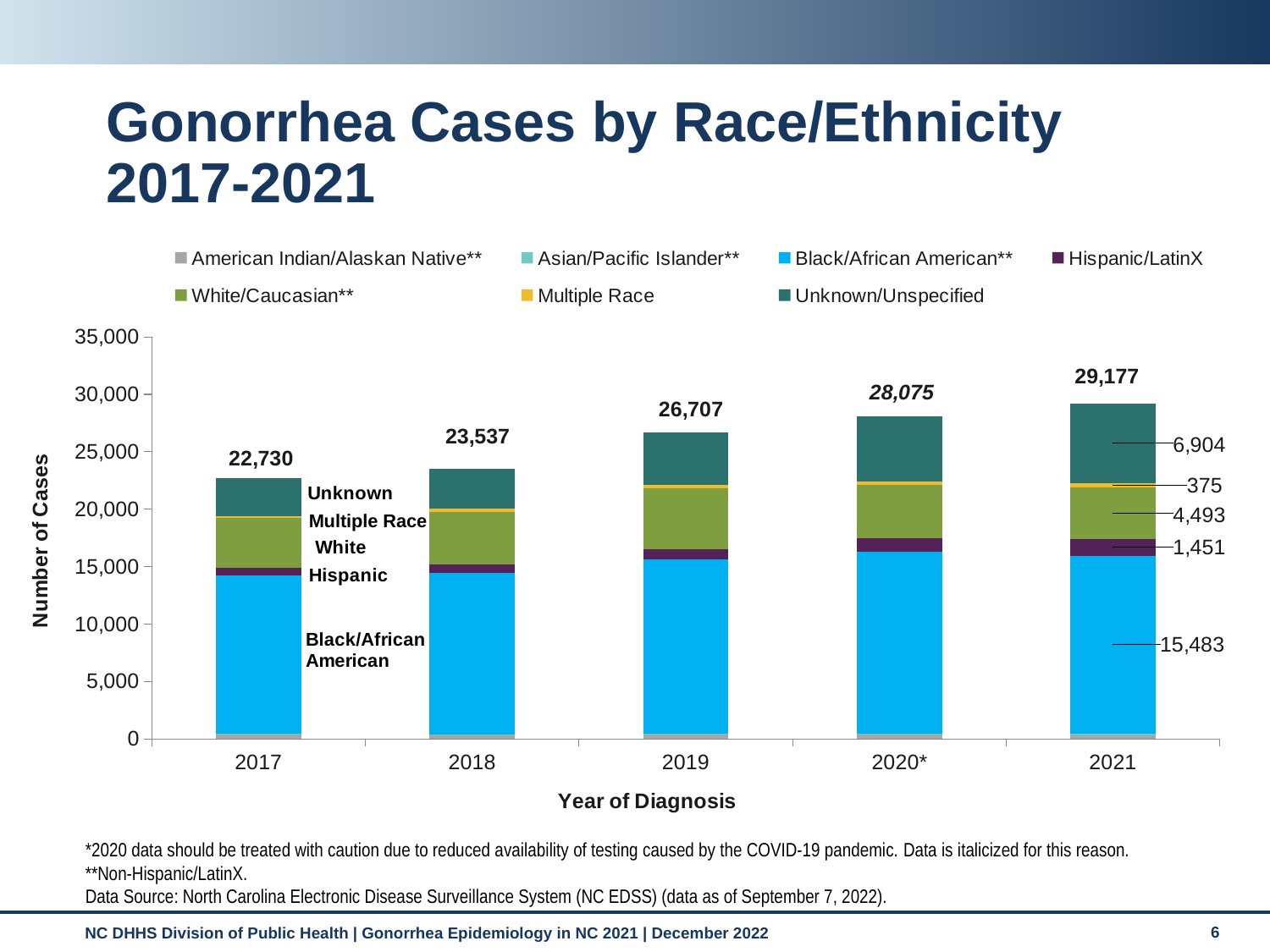
Which year has the lowest total number of cases? 2017 What is the total number of gonorrhea cases shown for 2021? 29,177 How many Black/African American cases are labeled for 2021? 15,483 Do total cases rise or fall from 2017 to 2021? rise How many race/ethnicity groups does the legend list? 7 Which year has the highest total number of cases? 2021 How many Unknown/Unspecified cases are labeled for 2021? 6,904 Which year has more total cases, 2018 or 2019? 2019 How many Hispanic/LatinX cases are labeled for 2021? 1,451 What is the difference between the total cases in 2021 and 2017? 6,447 How many years are shown on the x axis? 5 What is the total number of gonorrhea cases shown for 2017? 22,730